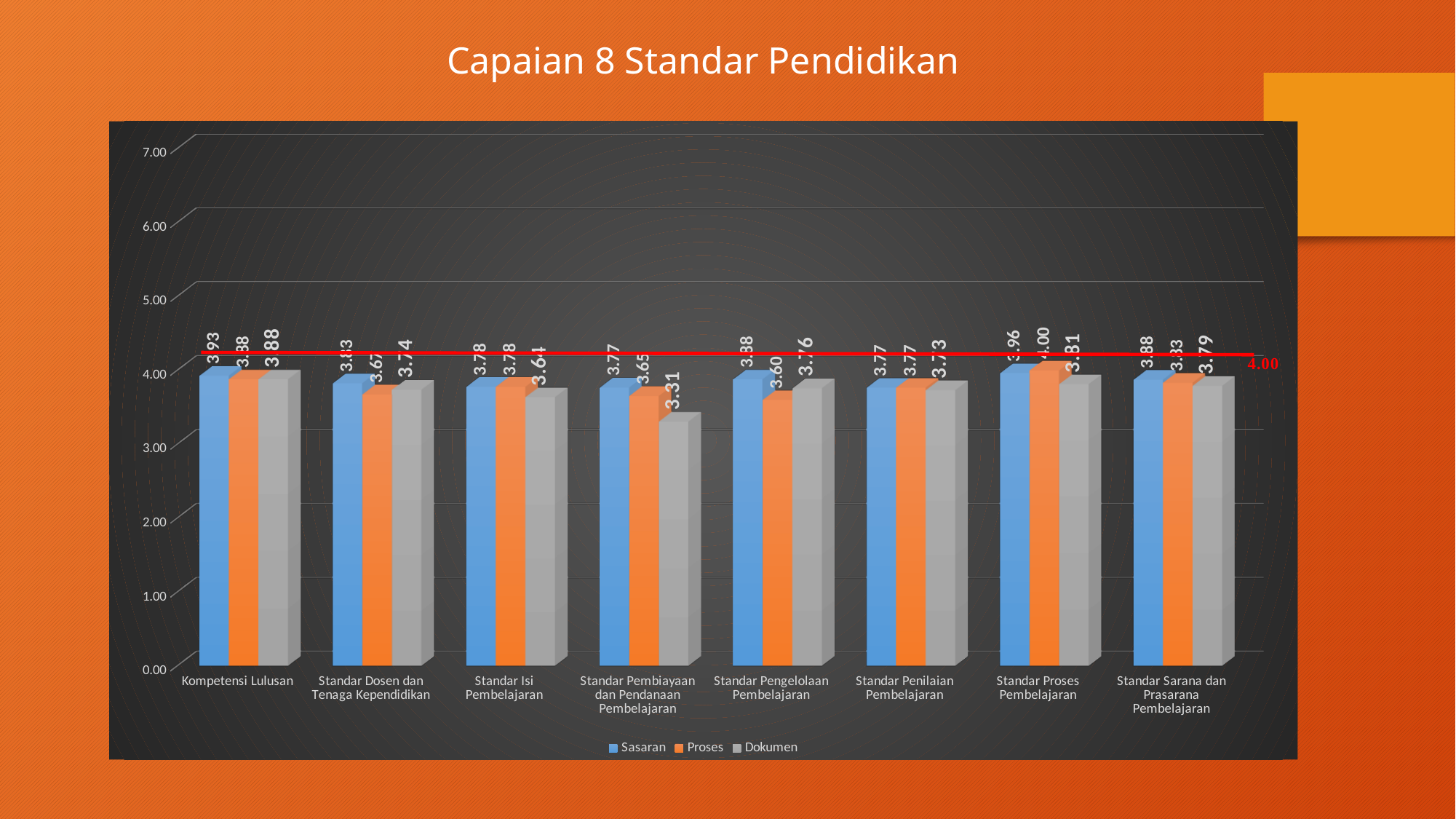
How many series does the legend list? 3 How many categories are shown on the x axis? 8 Which category has the highest Proses value? Standar Proses Pembelajaran What value is marked by the red horizontal line across the chart? 4.00 For Standar Pengelolaan Pembelajaran, which is larger: the Proses value or the Dokumen value? Dokumen What is the Dokumen value for Standar Pembiayaan dan Pendanaan Pembelajaran? 3.31 Which category has the lowest Dokumen value? Standar Pembiayaan dan Pendanaan Pembelajaran What is the difference between the Sasaran and Dokumen values for Standar Pembiayaan dan Pendanaan Pembelajaran? 0.46 What kind of chart is shown on the slide? Bar chart What is the Sasaran value for Kompetensi Lulusan? 3.93 What is the Proses value for Standar Proses Pembelajaran? 4.00 What is the Proses value for Standar Pengelolaan Pembelajaran? 3.60